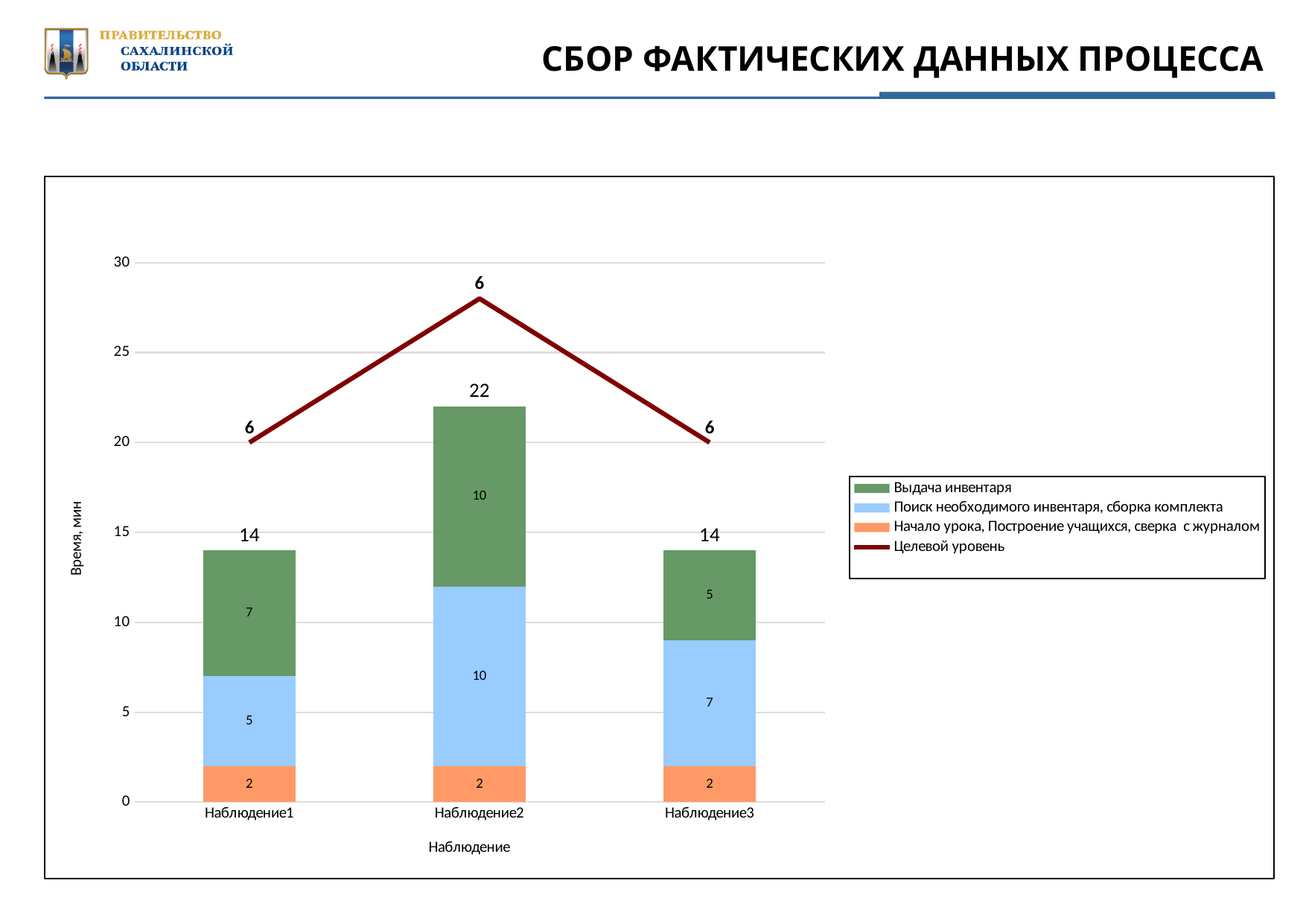
What is the difference between the total for Наблюдение2 and the total for Наблюдение1? 8 What is the value of the Выдача инвентаря segment for Наблюдение1? 7 Which observation has the highest total bar value? Наблюдение2 What kind of chart is shown on the slide? Stacked bar chart with a line How many observations (categories) are shown on the x axis? 3 How many entries does the legend list? 4 What is the data label shown for Целевой уровень at Наблюдение2? 6 What is the total value of the stacked bar for Наблюдение2? 22 Which is larger: the Выдача инвентаря segment for Наблюдение1 or for Наблюдение3? Наблюдение1 What is the value of the Поиск необходимого инвентаря, сборка комплекта segment for Наблюдение3? 7 What is the label of the y axis? Время, мин What is the value of the Начало урока, Построение учащихся, сверка с журналом segment for Наблюдение2? 2